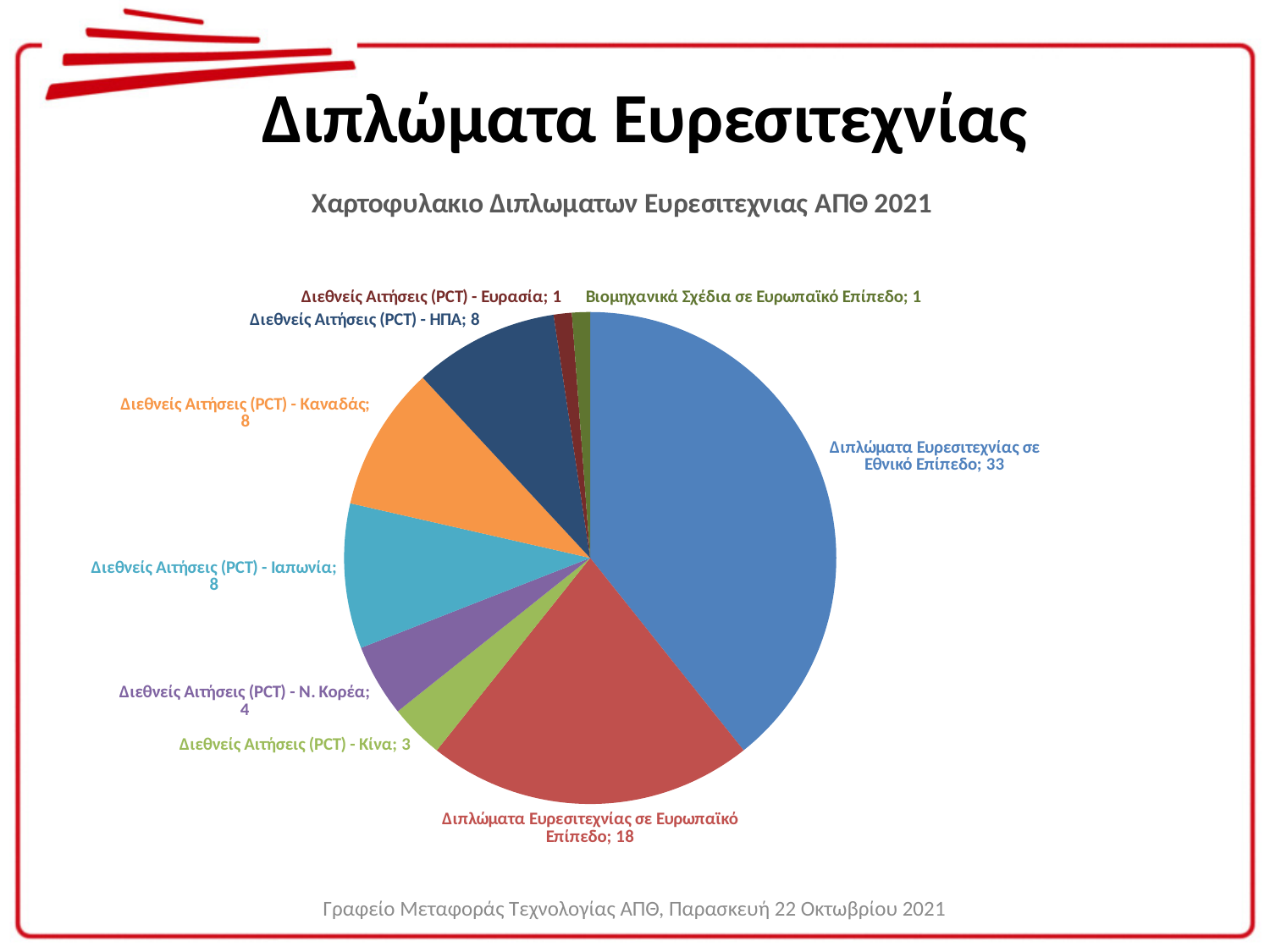
What is the value for Διπλώματα Ευρεσιτεχνίας σε Ευρωπαϊκό Επίπεδο? 18 What is the value for Διπλώματα Ευρεσιτεχνίας σε Εθνικό Επίπεδο? 33 Which is larger, the value for Διεθνείς Αιτήσεις (PCT) - Ιαπωνία or Διεθνείς Αιτήσεις (PCT) - Κίνα? Διεθνείς Αιτήσεις (PCT) - Ιαπωνία Which category has the largest slice of the pie? Διπλώματα Ευρεσιτεχνίας σε Εθνικό Επίπεδο What is the title of the chart? Χαρτοφυλακιο Διπλωματων Ευρεσιτεχνιας ΑΠΘ 2021 What is the total of all the values shown in the pie chart? 84 What kind of chart is shown on the slide? Pie chart What is the value for Διεθνείς Αιτήσεις (PCT) - Ν. Κορέα? 4 What is the difference between the values for Διπλώματα Ευρεσιτεχνίας σε Εθνικό Επίπεδο and Διπλώματα Ευρεσιτεχνίας σε Ευρωπαϊκό Επίπεδο? 15 How many slices does the pie chart have? 9 What share of the pie does Διπλώματα Ευρεσιτεχνίας σε Ευρωπαϊκό Επίπεδο represent, to the nearest whole percent? 21% What is the value for Διεθνείς Αιτήσεις (PCT) - Κίνα? 3